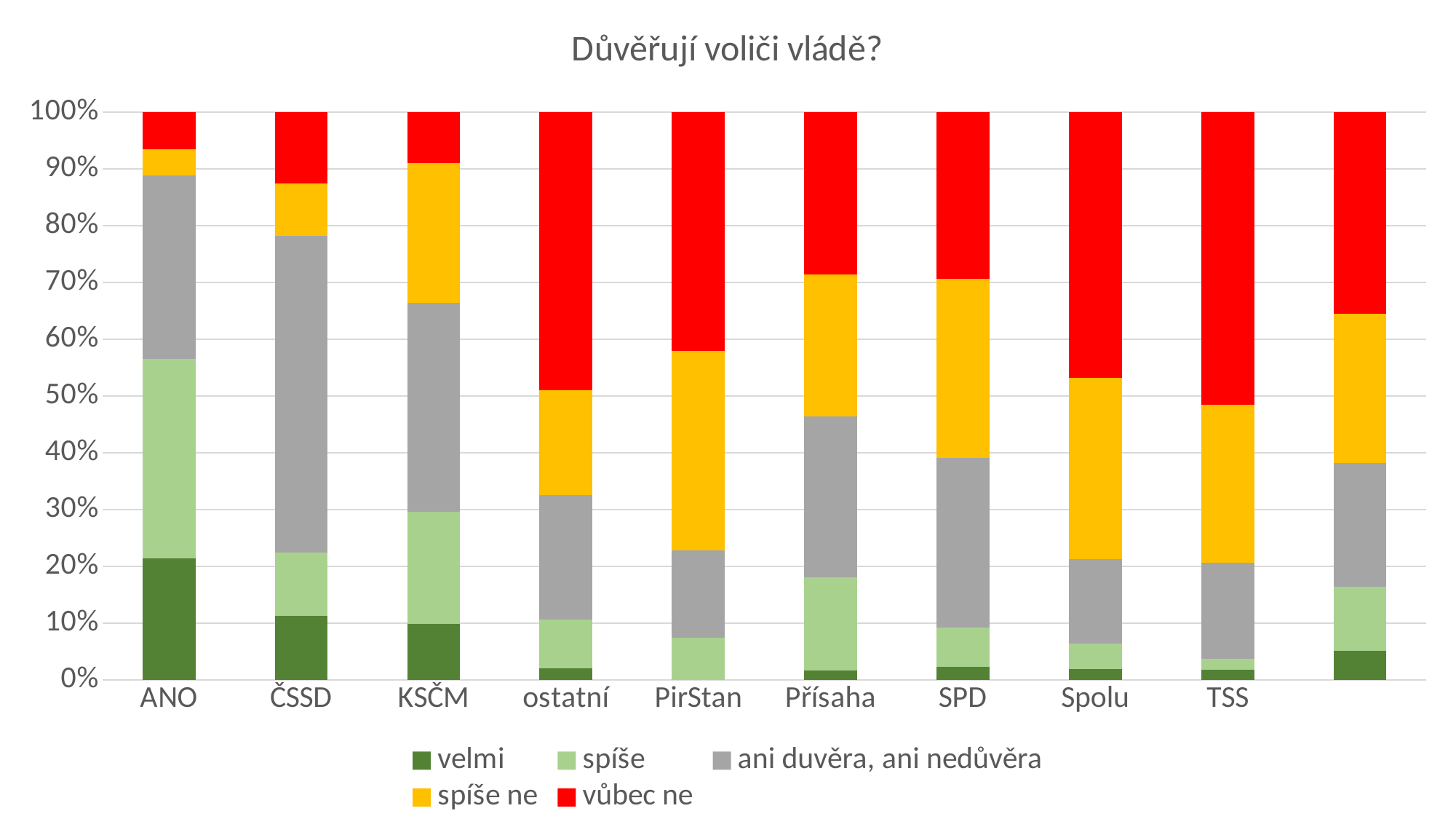
Is the "velmi" segment larger for ANO or for ČSSD? ANO What kind of chart is shown on the slide? stacked bar chart Is the "vůbec ne" value for ANO greater or less than 10%? less Which colour represents the series "vůbec ne" in the legend? red How many bars are plotted in the chart? 10 What is the title of the chart? Důvěřují voliči vládě? Which category has the largest "spíše" segment? ANO Which category has the largest "ani duvěra, ani nedůvěra" segment? ČSSD Is the "vůbec ne" segment larger for ANO or for Spolu? Spolu Is the "velmi" value for ANO greater or less than 10%? greater Which category has the largest "velmi" segment? ANO How many series does the legend list? 5